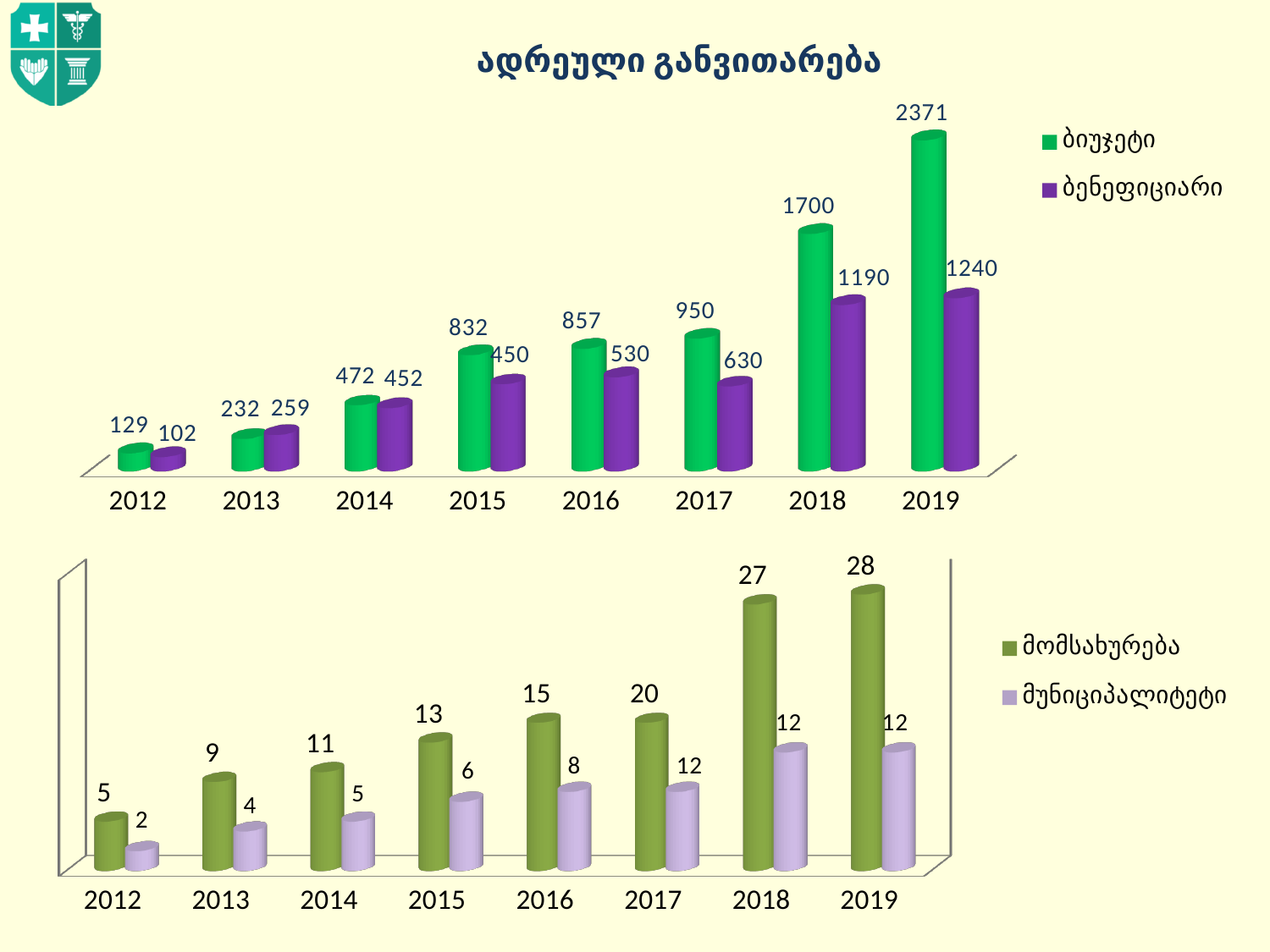
In the top chart, what is the value of ბენეფიციარი for 2016? 530 How many years are shown on the x axis of the bottom chart? 8 In the top chart, what is the difference between ბიუჯეტი and ბენეფიციარი in 2018? 510 What kind of chart is the bottom chart? Bar chart In the bottom chart, what is the difference between მომსახურება and მუნიციპალიტეტი in 2019? 16 In the top chart, which is larger in 2013: ბიუჯეტი or ბენეფიციარი? ბენეფიციარი In the bottom chart, what is the value of მომსახურება for 2017? 20 In the top chart, which year has the lowest ბენეფიციარი value? 2012 In the bottom chart, what is the value of მუნიციპალიტეტი for 2015? 6 How many series does the legend of the top chart list? 2 In the top chart, which year has the highest ბიუჯეტი value? 2019 In the top chart, what is the value of ბიუჯეტი for 2019? 2371